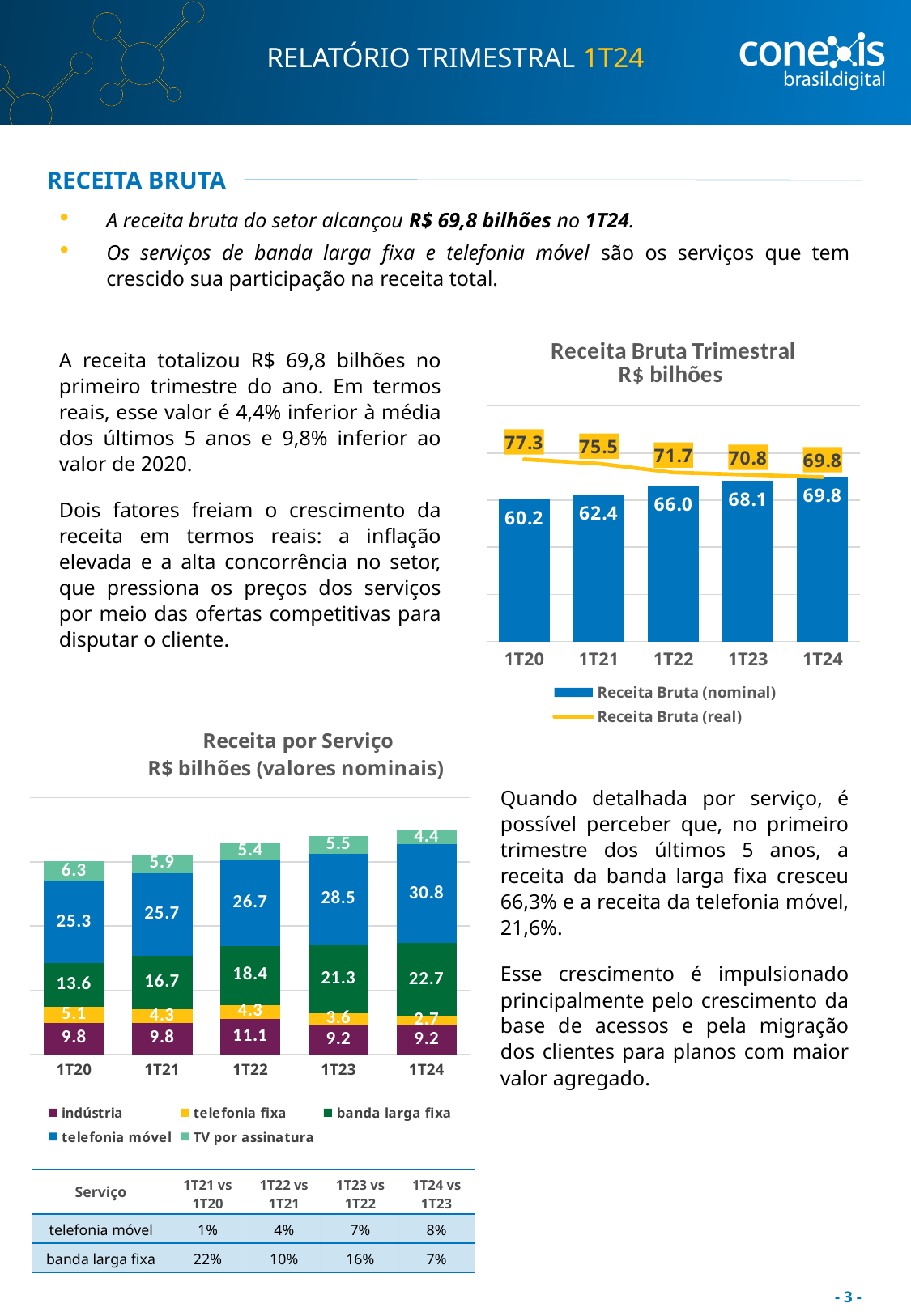
In the 'Receita por Serviço' chart, which quarter has the lowest value for telefonia fixa? 1T24 In the 'Receita por Serviço' chart, what is the value for telefonia móvel in 1T24? 30.8 In the 'Receita por Serviço' chart, what is the value for banda larga fixa in 1T22? 18.4 In the 'Receita por Serviço' chart, how many series does the legend list? 5 What kind of chart is the 'Receita por Serviço' chart? stacked bar chart In the 'Receita por Serviço' chart, what is the total of the stacked bar for 1T24? 69.8 In the 'Receita Bruta Trimestral' chart, what is the difference between Receita Bruta (real) and Receita Bruta (nominal) in 1T21? 13.1 In the 'Receita Bruta Trimestral' chart, what is the value of Receita Bruta (nominal) for 1T22? 66.0 In the 'Receita Bruta Trimestral' chart, does Receita Bruta (real) rise or fall from 1T20 to 1T24? fall In the 'Receita Bruta Trimestral' chart, what is the value of Receita Bruta (real) for 1T20? 77.3 In the 'Receita Bruta Trimestral' chart, which quarter has the highest Receita Bruta (nominal)? 1T24 How many series does the legend of the 'Receita Bruta Trimestral' chart list? 2